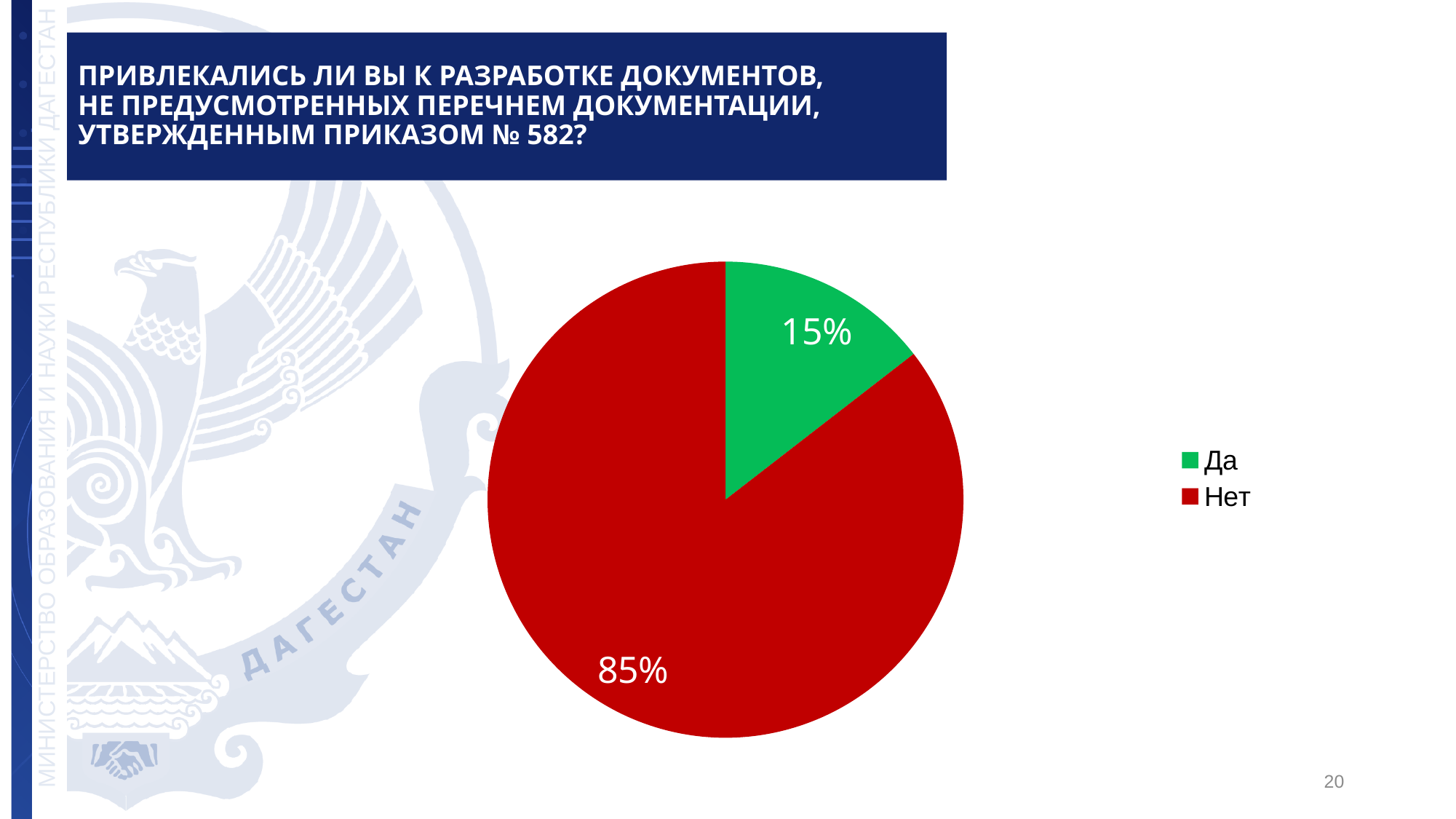
How many entries does the legend list? 2 What kind of chart is shown on the slide? pie chart Which answer has the largest share of the pie? Нет Which slice is larger, "Да" or "Нет"? Нет What share of the pie does the "Нет" slice represent? 85% Which answer has the smallest share of the pie? Да What colour is the "Нет" slice? red What percentage of respondents answered "Да"? 15% What colour is the "Да" slice? green What is the difference in percentage points between the "Нет" and "Да" slices? 70 What percentage of respondents answered "Нет"? 85% How many slices does the pie chart have? 2